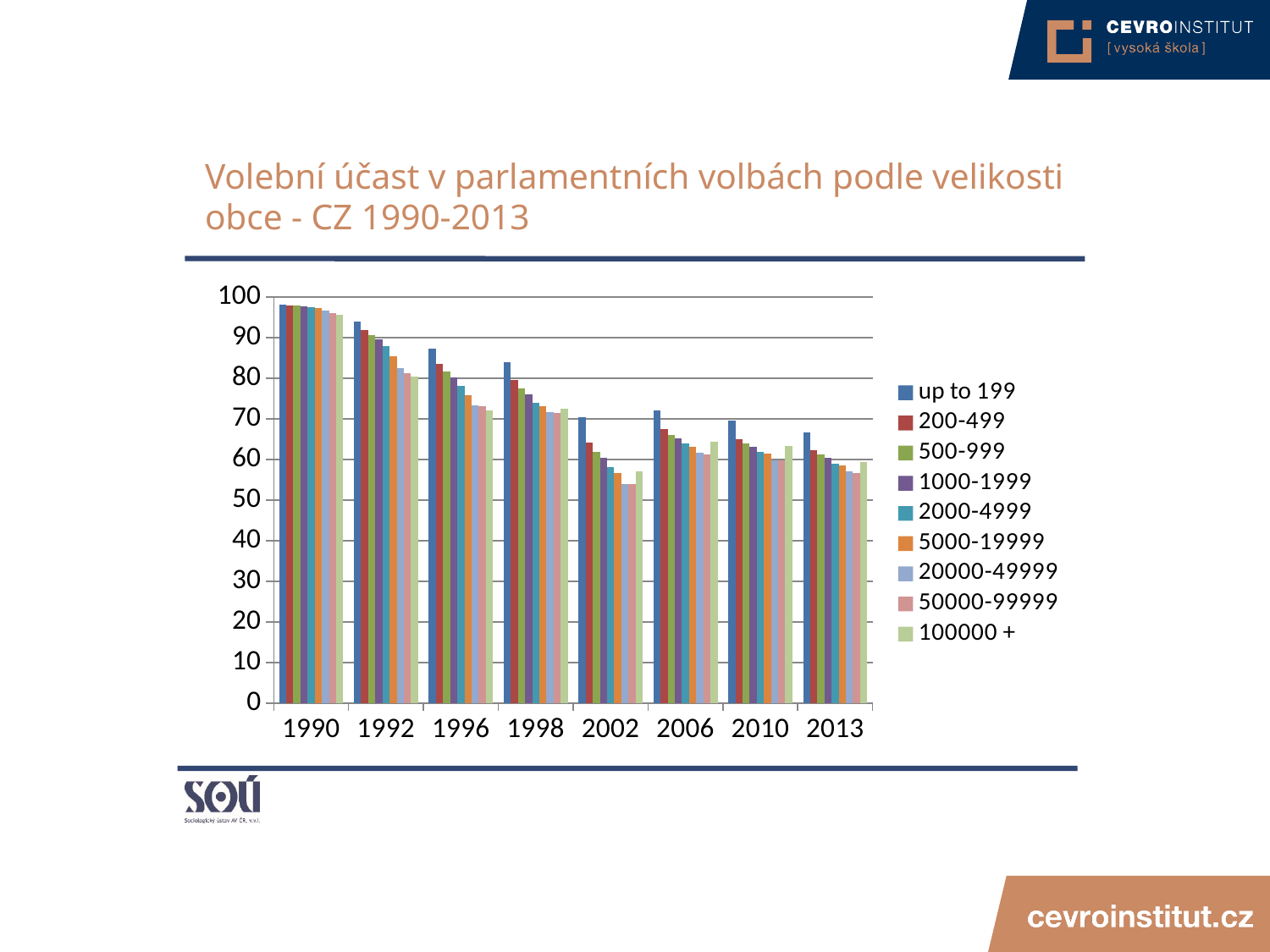
In 2002, which is larger: the value for 'up to 199' or the value for '50000-99999'? up to 199 Is the value for 'up to 199' in 1996 greater or less than 80? greater Is the value for '50000-99999' in 2002 greater or less than 60? less Is the value for 'up to 199' in 1990 greater or less than 90? greater What is the title of the chart on the slide? Volební účast v parlamentních volbách podle velikosti obce - CZ 1990-2013 In which year is the value for 'up to 199' the highest? 1990 What kind of chart is shown on the slide? bar chart How many election years are shown on the x axis of the chart? 8 Which legend entry represents the largest municipality size category? 100000 + How many series does the chart's legend list? 9 In which year is the value for '50000-99999' the lowest? 2002